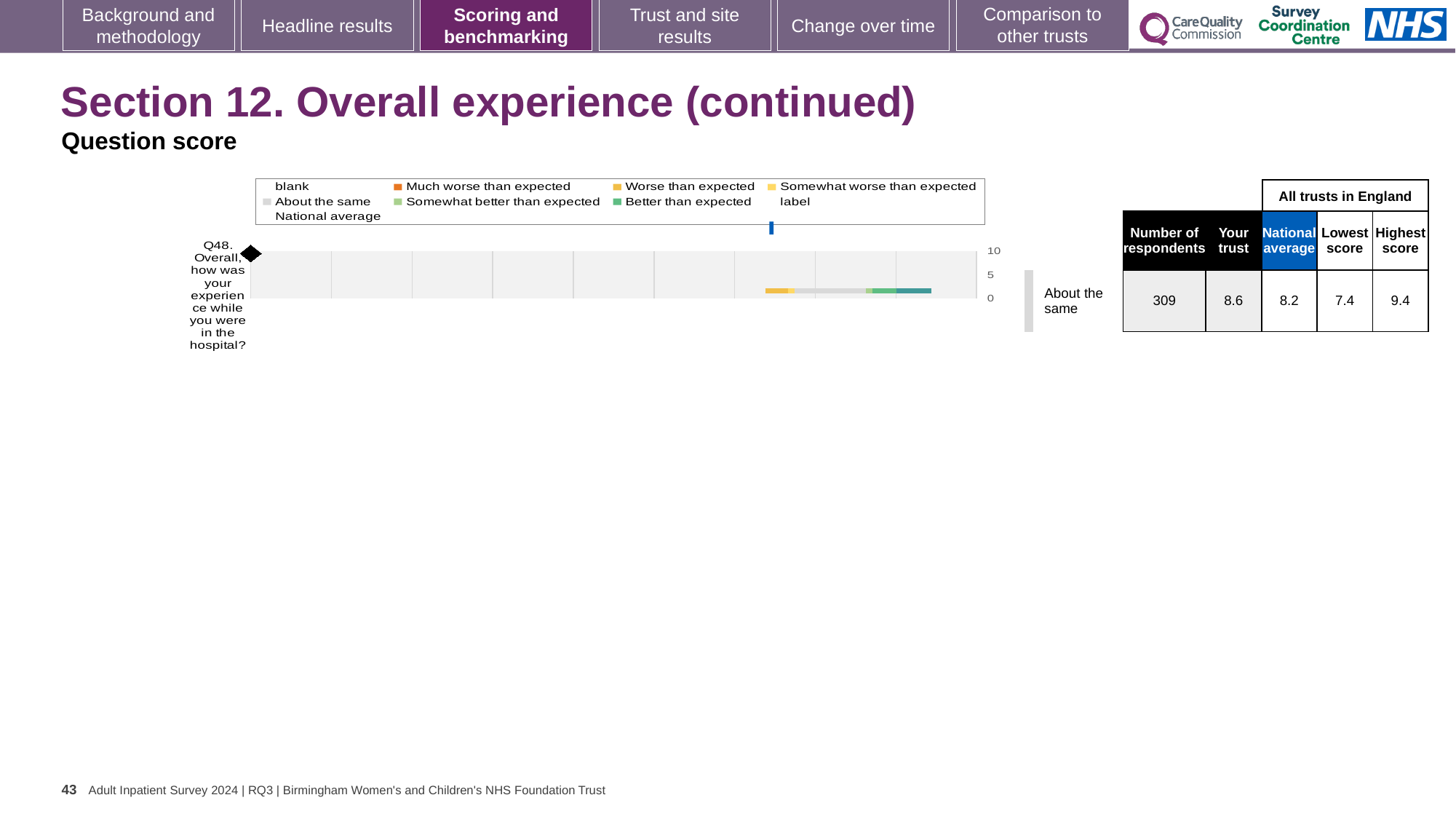
In the table beside the chart, what is the highest score among all trusts in England for Q48? 9.4 What benchmark category is shown next to the chart for Q48? About the same In the table beside the chart, what is the national average score for Q48? 8.2 What is the highest tick value shown on the chart's axis? 10 In the table beside the chart, what is the difference between the highest score and the lowest score for Q48? 2.0 What kind of chart is shown for Q48 on this slide? bar chart In the table beside the chart, what is the 'Your trust' score for Q48? 8.6 In the table beside the chart, what is the lowest score among all trusts in England for Q48? 7.4 In the table beside the chart, which is larger for Q48: the 'Your trust' score or the national average? Your trust How many survey questions are plotted in the chart? 1 Which question is plotted in the chart? Q48. Overall, how was your experience while you were in the hospital? In the table beside the chart, what is the number of respondents for Q48? 309